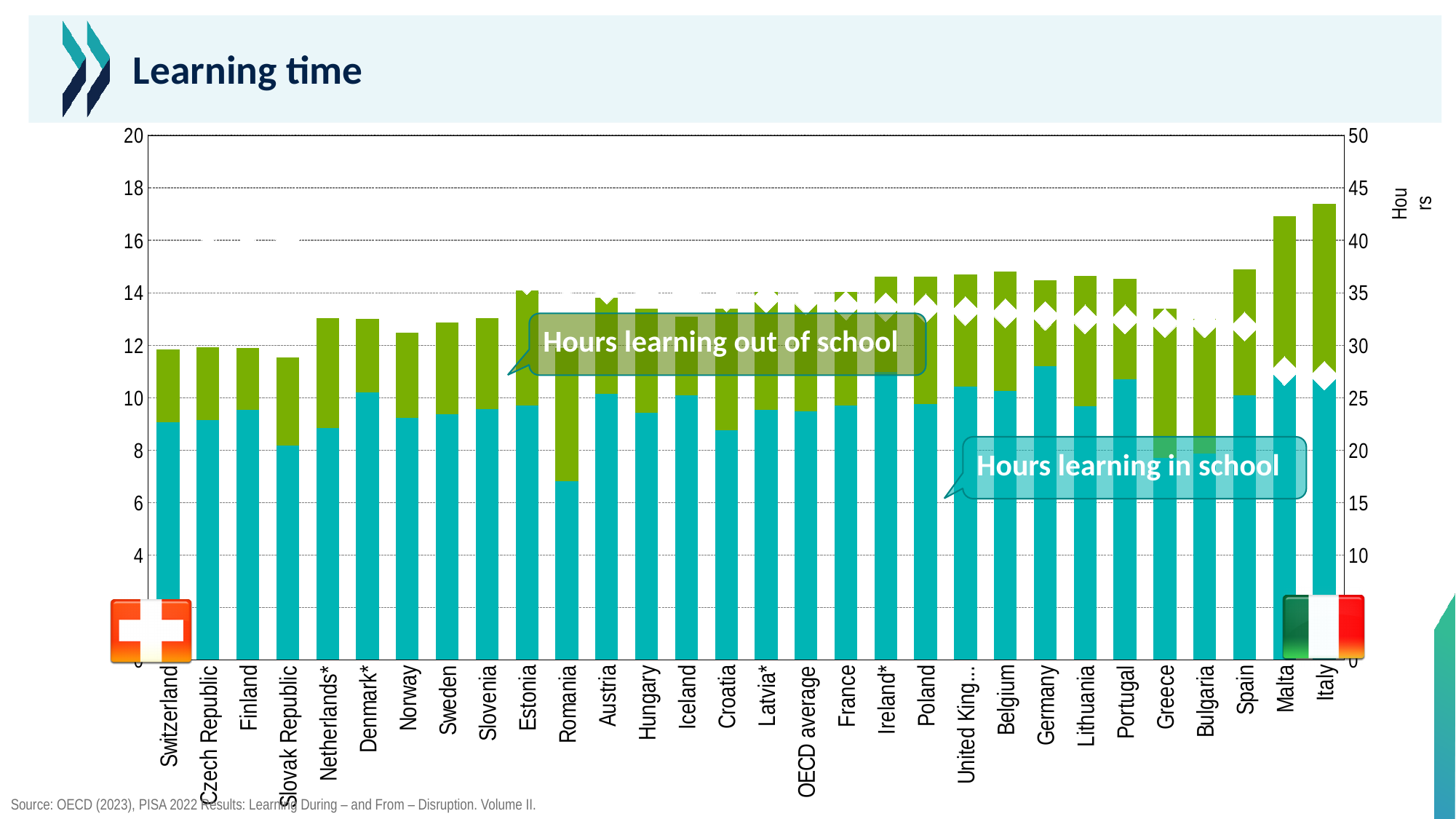
What does the teal (lower) segment of each bar represent? Hours learning in school Is the total bar for Italy greater or less than 16 on the left axis? greater Which country has the lowest hours learning in school? Romania Do the total bars generally rise or fall moving from left to right along the x axis? rise Which country has the highest total bar (in school plus out of school)? Italy Is the hours learning in school value for Germany greater or less than 10? greater What kind of chart is shown on the slide? Combination chart: stacked bars with a line series (white diamond markers) How many countries/categories are shown along the x axis? 30 Is the hours learning in school value for Romania greater or less than 8? less What does the green segment of each bar represent? Hours learning out of school Which has the larger total bar, Switzerland or Italy? Italy